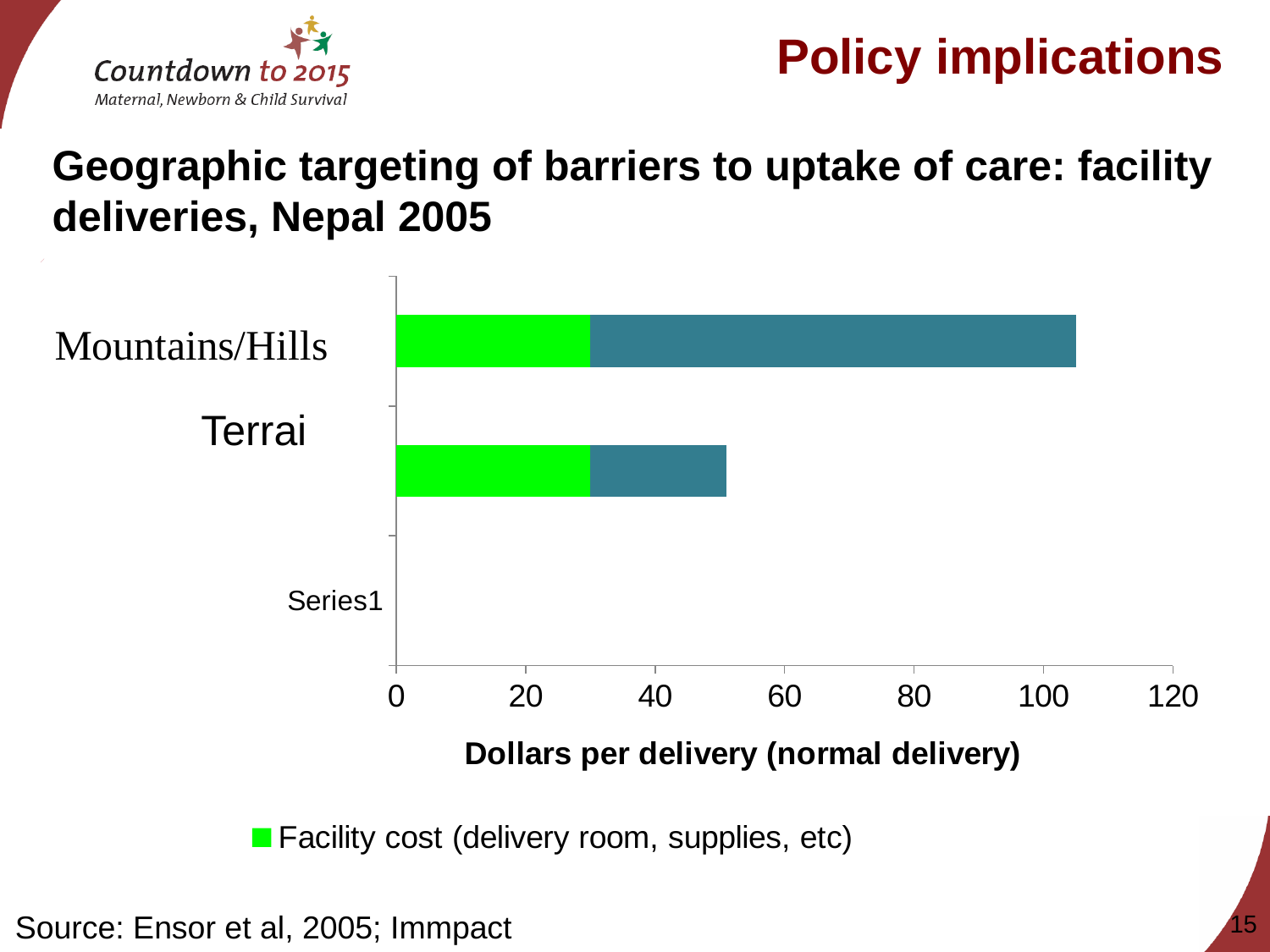
Which has a larger total dollars per delivery, Mountains/Hills or Terrai? Mountains/Hills What kind of chart is shown on the slide? bar chart What is the legend entry shown below the chart? Facility cost (delivery room, supplies, etc) What colour represents facility cost in the chart? green How many series does the chart's legend list? 1 Which of the plotted categories has the shortest total bar? Terrai Is the total value for Mountains/Hills greater or less than 80? greater Is the total value for Terrai greater or less than 60? less Which category has the longest total bar? Mountains/Hills How many categories have bars plotted in the chart? 2 Is the facility cost segment for Terrai greater or less than 40? less What is the title of the x axis? Dollars per delivery (normal delivery)